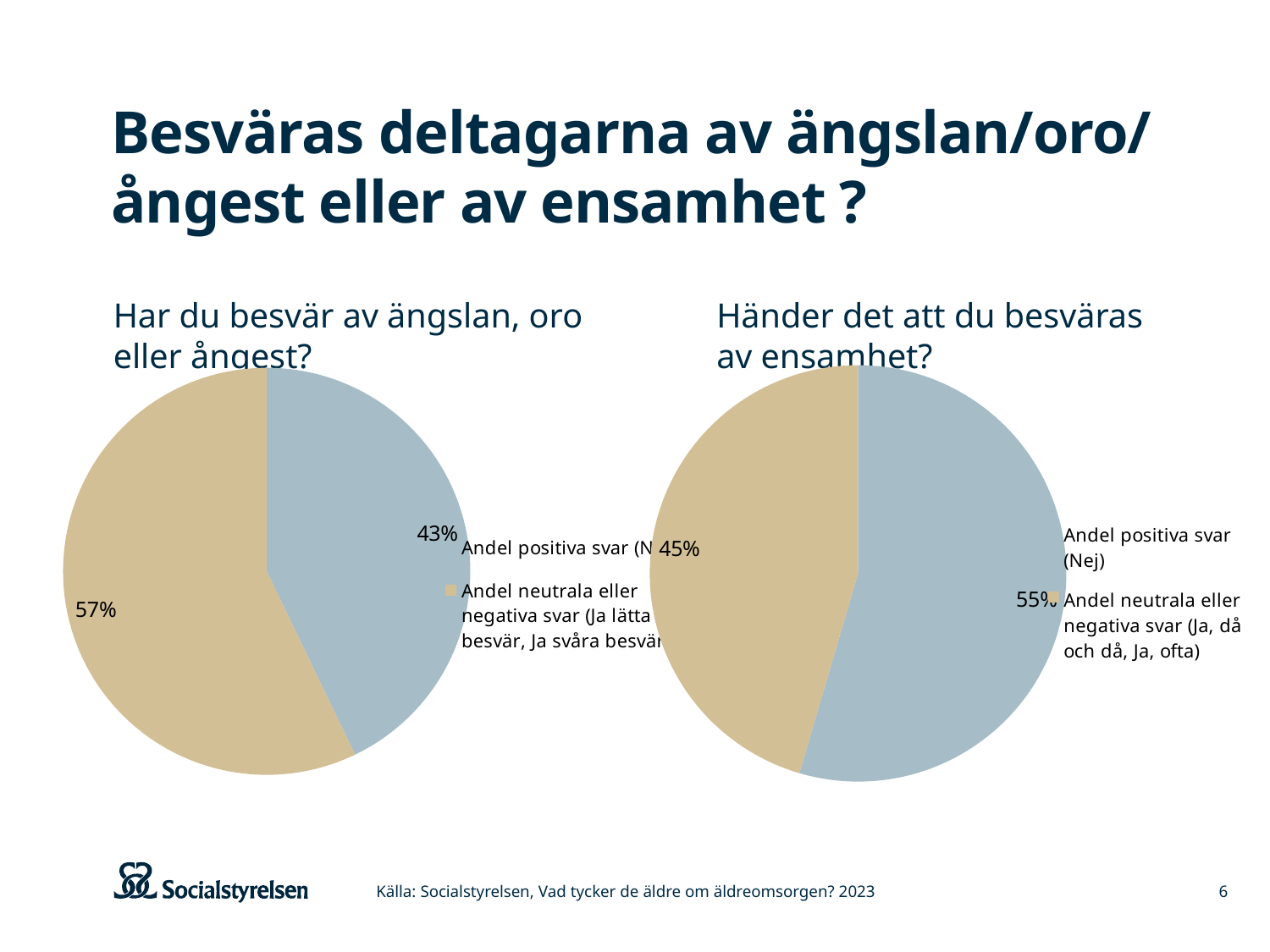
In the right pie chart 'Händer det att du besväras av ensamhet?', what share is labelled for 'Andel positiva svar (Nej)'? 55% What type of chart is used for 'Händer det att du besväras av ensamhet?'? Pie chart In the left pie chart 'Har du besvär av ängslan, oro eller ångest?', what is the difference in percentage points between the two slices? 14 percentage points How many charts are shown on the slide? 2 Is the share of 'Andel positiva svar (Nej)' larger in the left pie chart or in the right pie chart? Right pie chart In the right pie chart 'Händer det att du besväras av ensamhet?', what is the difference in percentage points between the two slices? 10 percentage points In the left pie chart 'Har du besvär av ängslan, oro eller ångest?', what share is labelled for 'Andel positiva svar (Nej)'? 43% In the left pie chart 'Har du besvär av ängslan, oro eller ångest?', which slice is the largest? Andel neutrala eller negativa svar In the left pie chart 'Har du besvär av ängslan, oro eller ångest?', what share is labelled for 'Andel neutrala eller negativa svar'? 57% How many slices does the left pie chart 'Har du besvär av ängslan, oro eller ångest?' have? 2 In the right pie chart 'Händer det att du besväras av ensamhet?', which slice is the smallest? Andel neutrala eller negativa svar In the right pie chart 'Händer det att du besväras av ensamhet?', what share is labelled for 'Andel neutrala eller negativa svar'? 45%